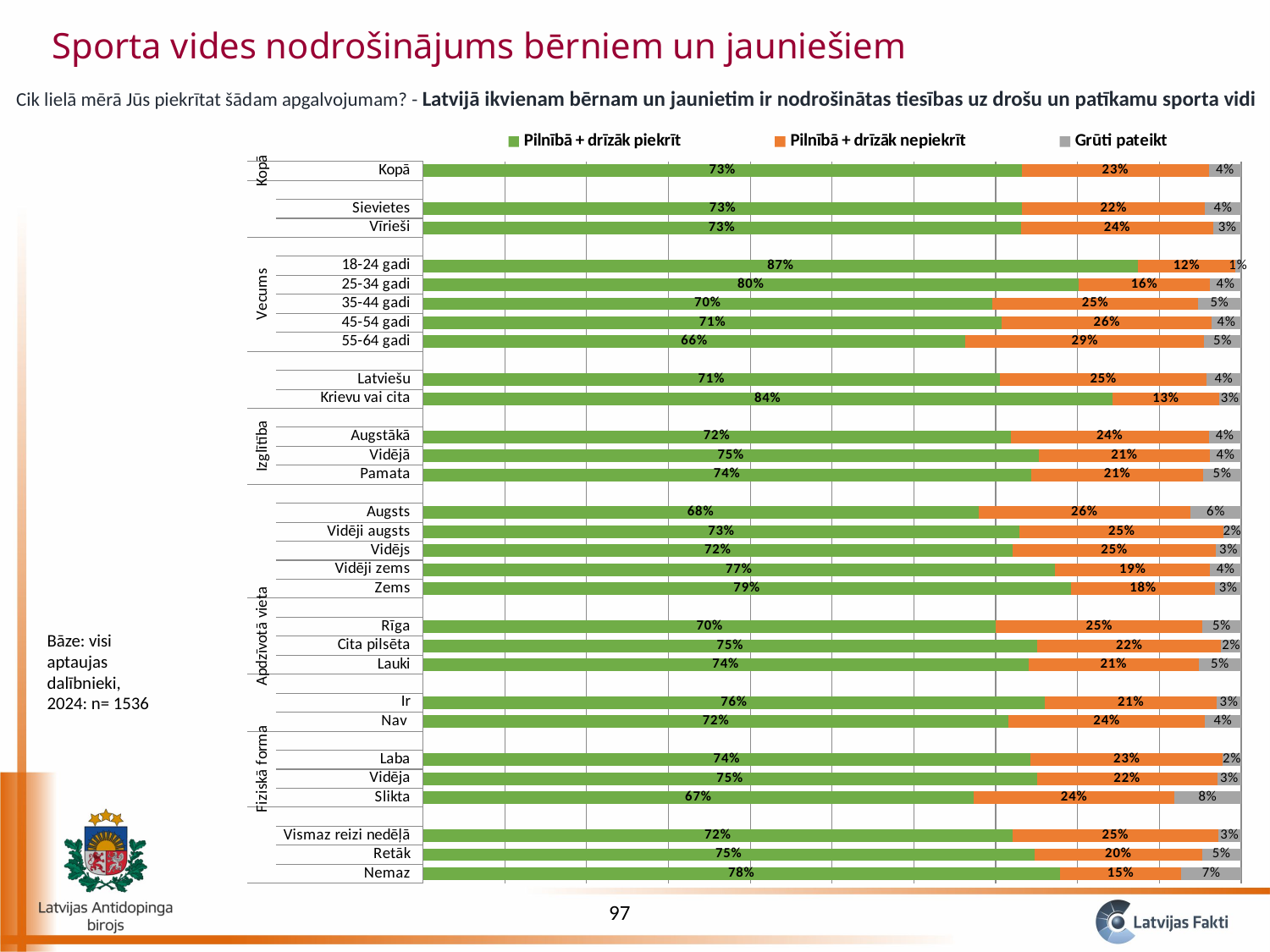
Which category has the highest "Pilnībā + drīzāk piekrīt" value? 18-24 gadi What is the difference between the "Pilnībā + drīzāk piekrīt" values for Krievu vai cita and Latviešu? 13 percentage points Which colour represents "Grūti pateikt" in the chart? Grey Which category has the highest "Pilnībā + drīzāk nepiekrīt" value? 55-64 gadi What is the "Grūti pateikt" value for Slikta? 8% What is the "Pilnībā + drīzāk nepiekrīt" value for Kopā? 23% How many series does the legend list? 3 Which has a larger "Pilnībā + drīzāk piekrīt" value, Rīga or Cita pilsēta? Cita pilsēta What percentage of the 18-24 gadi group chose "Pilnībā + drīzāk piekrīt"? 87% What is the total of the stacked bar for Nemaz? 100% Which category has the lowest "Pilnībā + drīzāk piekrīt" value? 55-64 gadi What kind of chart is shown on the slide? Stacked horizontal bar chart